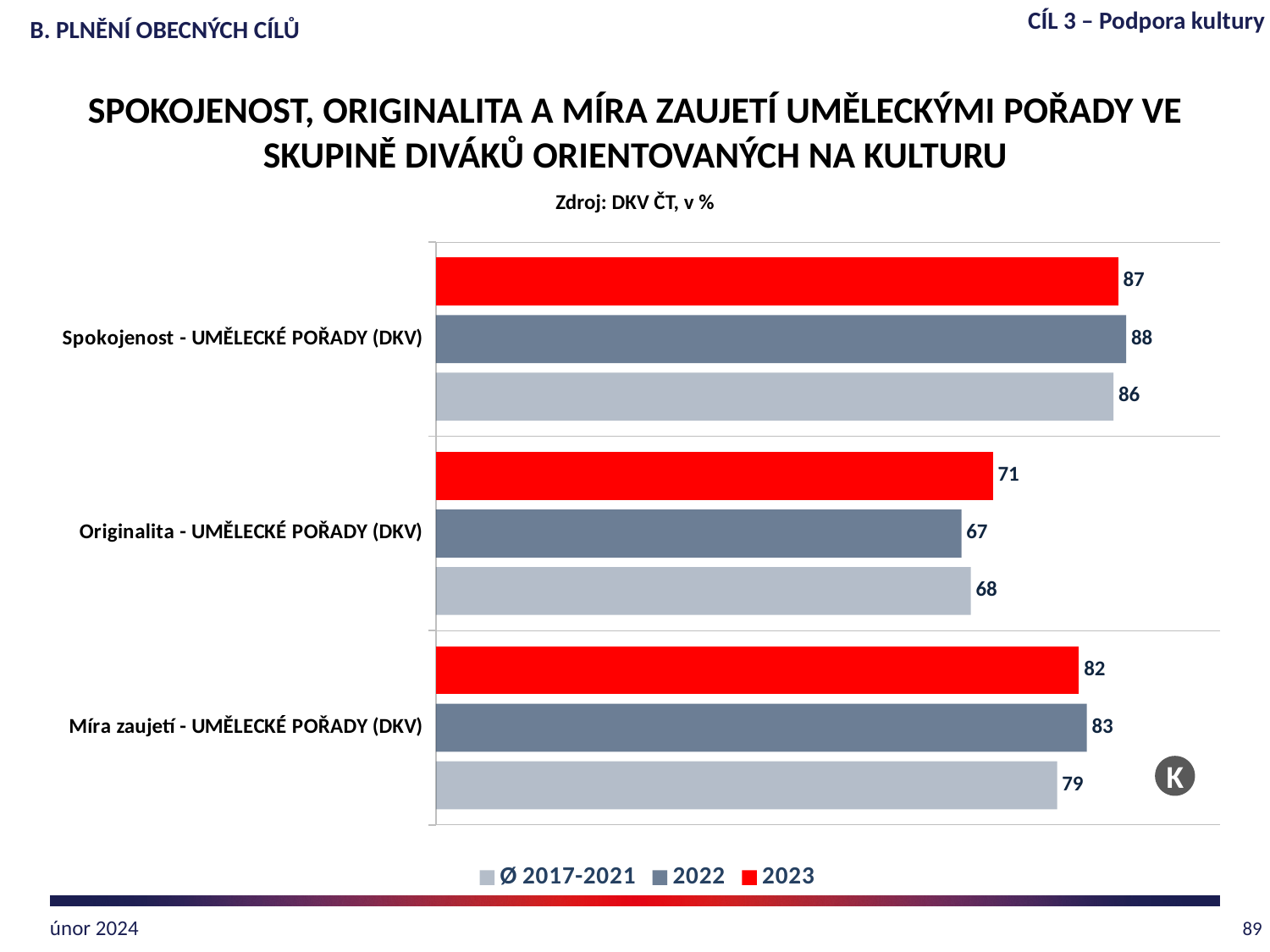
What is the Ø 2017-2021 value for Míra zaujetí - UMĚLECKÉ POŘADY (DKV)? 79 How many categories are shown on the chart? 3 Which category has the highest 2022 value? Spokojenost - UMĚLECKÉ POŘADY (DKV) What is the 2023 value for Míra zaujetí - UMĚLECKÉ POŘADY (DKV)? 82 How many series does the legend list? 3 For Spokojenost - UMĚLECKÉ POŘADY (DKV), which is larger: the 2022 value or the Ø 2017-2021 value? 2022 What kind of chart is shown on the slide? Bar chart Which category has the lowest 2023 value? Originalita - UMĚLECKÉ POŘADY (DKV) What is the 2022 value for Originalita - UMĚLECKÉ POŘADY (DKV)? 67 What is the 2023 value for Spokojenost - UMĚLECKÉ POŘADY (DKV)? 87 What is the difference between the 2023 and 2022 values for Originalita - UMĚLECKÉ POŘADY (DKV)? 4 What is the difference between the 2022 and Ø 2017-2021 values for Míra zaujetí - UMĚLECKÉ POŘADY (DKV)? 4